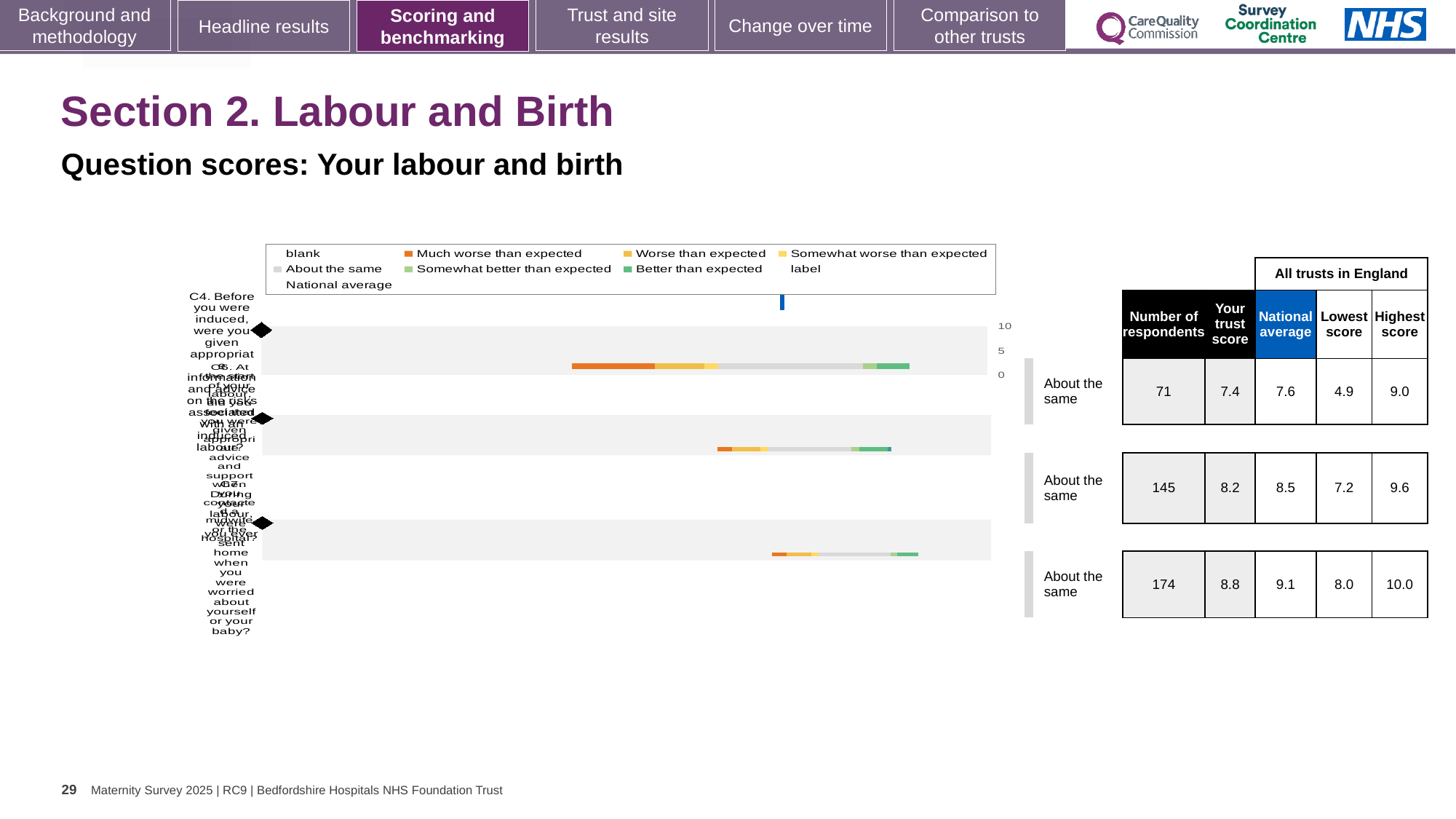
Is the trust score for the middle row larger or smaller than its national average? smaller In the table next to the chart, what is the trust score for the top row? 7.4 In the table next to the chart, what is the highest score for the bottom row? 10.0 In the table next to the chart, what is the lowest score for the middle row? 7.2 What is the difference between the national average and the trust score for the bottom row in the table? 0.3 What benchmark label is shown beside each of the three bars? About the same Which row has the highest number of respondents in the table next to the chart? the bottom row (174) What colour represents 'Much worse than expected' in the chart legend? orange In the table next to the chart, what is the number of respondents for the top row? 71 In the table next to the chart, what is the national average for the middle row? 8.5 How many question rows (bars) are plotted in the chart? 3 What kind of chart is shown on the slide? bar chart